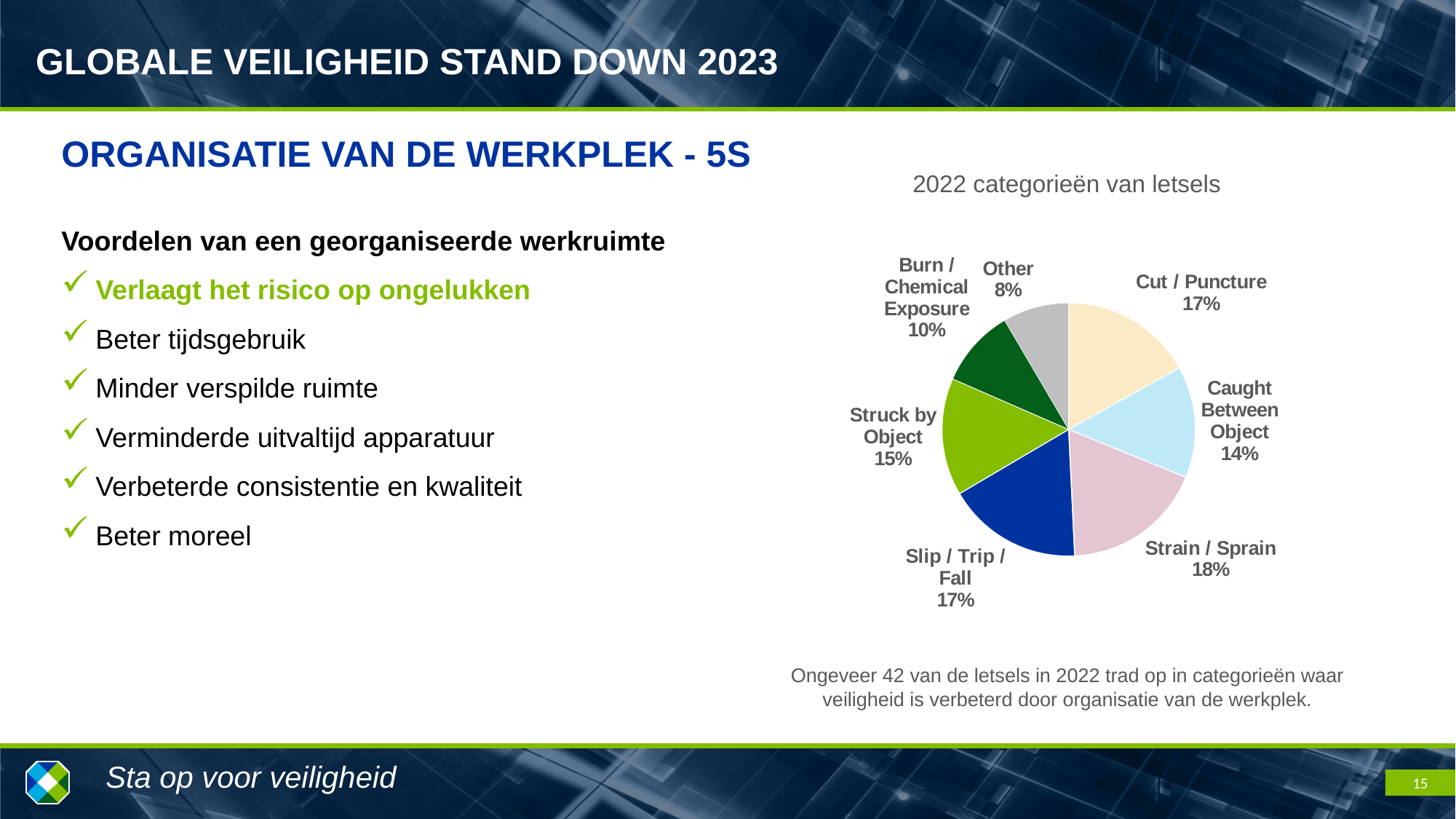
Which injury category has the smallest share? Other What type of chart is shown on the slide? pie chart How many injury categories are shown in the pie chart? 7 What share of injuries is Struck by Object? 15% What is the difference in percentage points between Strain / Sprain and Other? 10 What is the title of the chart? 2022 categorieën van letsels What colour is the Slip / Trip / Fall slice? dark blue What share of injuries is Burn / Chemical Exposure? 10% What share of injuries is Caught Between Object? 14% Which is larger, the share for Struck by Object or the share for Burn / Chemical Exposure? Struck by Object What share of injuries is Strain / Sprain? 18% Which injury category has the largest share? Strain / Sprain